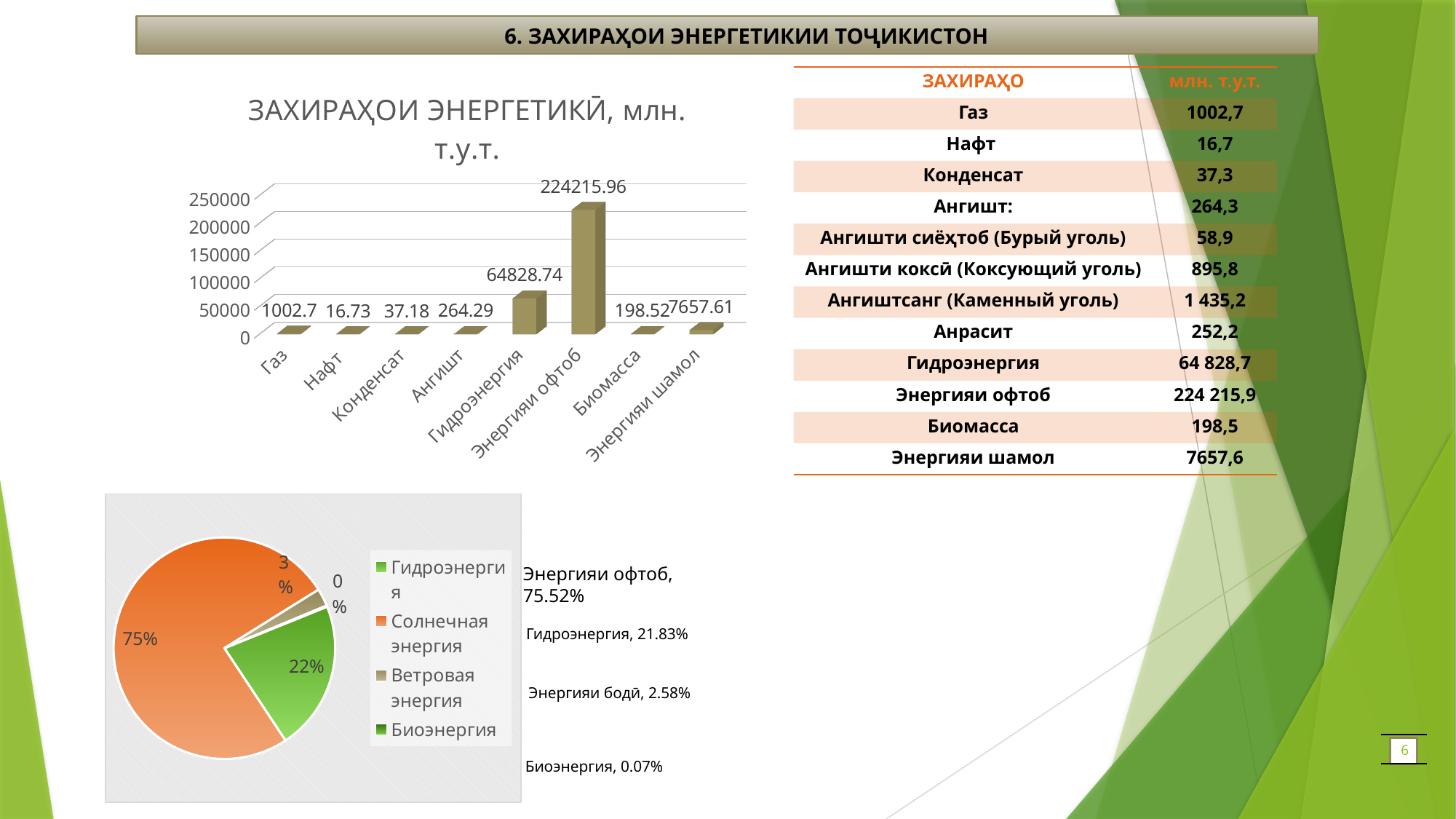
In the bar chart titled 'ЗАХИРАҲОИ ЭНЕРГЕТИКӢ, млн. т.у.т.', what is the value for Энергияи шамол? 7657.61 In the bar chart titled 'ЗАХИРАҲОИ ЭНЕРГЕТИКӢ, млн. т.у.т.', which category has the lowest value? Нафт What kind of chart is the chart titled 'ЗАХИРАҲОИ ЭНЕРГЕТИКӢ, млн. т.у.т.'? bar chart In the bar chart titled 'ЗАХИРАҲОИ ЭНЕРГЕТИКӢ, млн. т.у.т.', which is larger, the value for Газ or the value for Ангишт? Газ In the pie chart at the bottom left of the slide, how many entries does the legend list? 4 In the bar chart titled 'ЗАХИРАҲОИ ЭНЕРГЕТИКӢ, млн. т.у.т.', what is the difference between the values for Энергияи офтоб and Гидроэнергия? 159387.22 In the bar chart titled 'ЗАХИРАҲОИ ЭНЕРГЕТИКӢ, млн. т.у.т.', what is the value for Гидроэнергия? 64828.74 In the bar chart titled 'ЗАХИРАҲОИ ЭНЕРГЕТИКӢ, млн. т.у.т.', what is the value for Энергияи офтоб? 224215.96 In the bar chart titled 'ЗАХИРАҲОИ ЭНЕРГЕТИКӢ, млн. т.у.т.', how many categories are shown on the x axis? 8 In the bar chart titled 'ЗАХИРАҲОИ ЭНЕРГЕТИКӢ, млн. т.у.т.', what is the value for Нафт? 16.73 In the pie chart at the bottom left of the slide, what share is shown for the Солнечная энергия slice? 75% In the bar chart titled 'ЗАХИРАҲОИ ЭНЕРГЕТИКӢ, млн. т.у.т.', which category has the highest value? Энергияи офтоб